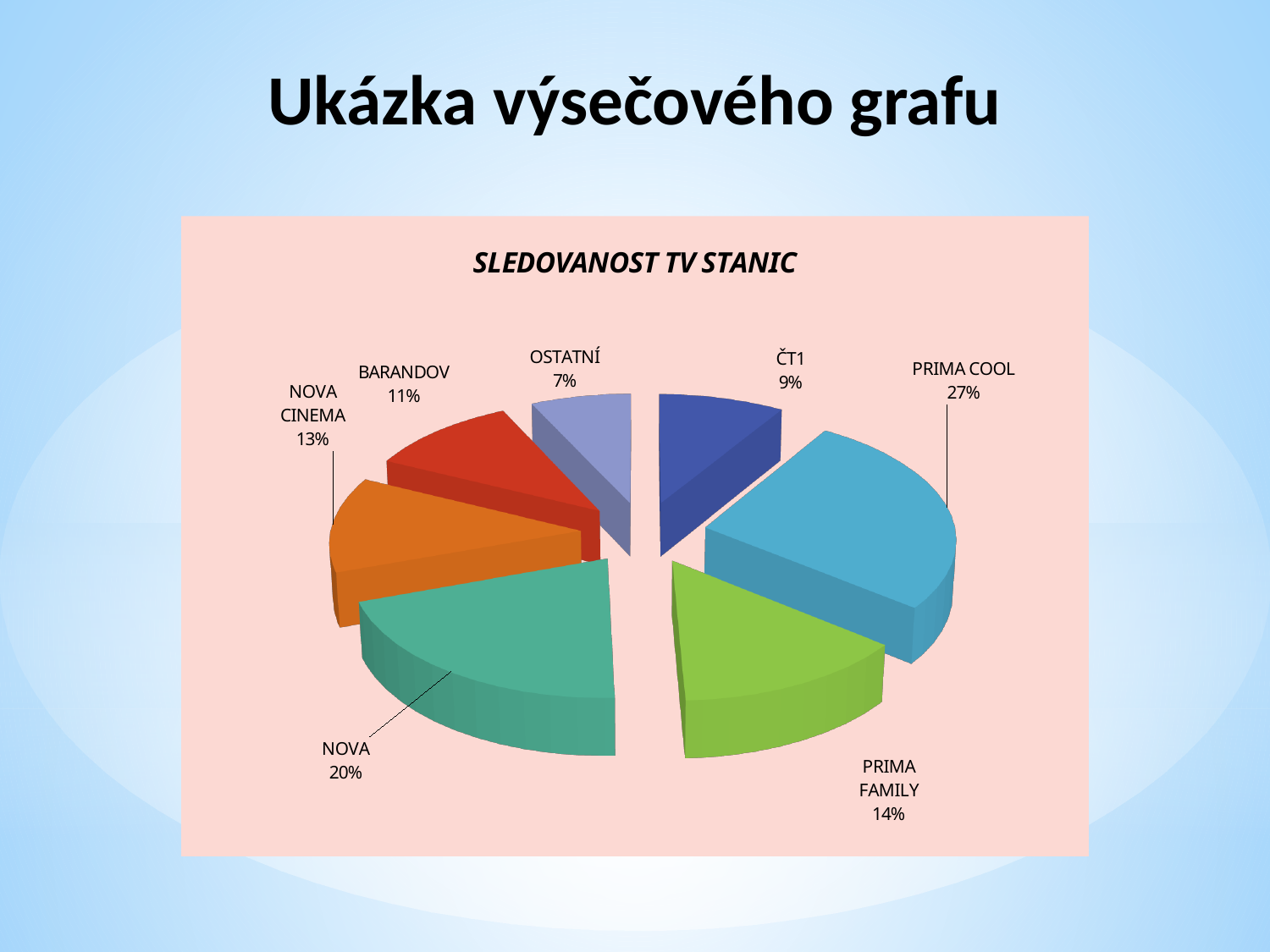
What kind of chart is shown on the slide? Pie chart What is the value shown for NOVA? 20% What is the value shown for OSTATNÍ? 7% Which TV station has the largest slice of the pie? PRIMA COOL What is the title of the chart? SLEDOVANOST TV STANIC Which category has the smallest slice of the pie? OSTATNÍ What is the value shown for ČT1? 9% Which has a larger share, NOVA CINEMA or BARANDOV? NOVA CINEMA How many slices does the pie chart have? 7 What share of the pie does PRIMA COOL have? 27% What is the difference between the shares of PRIMA COOL and NOVA? 7% What is the difference between the shares of PRIMA FAMILY and ČT1? 5%